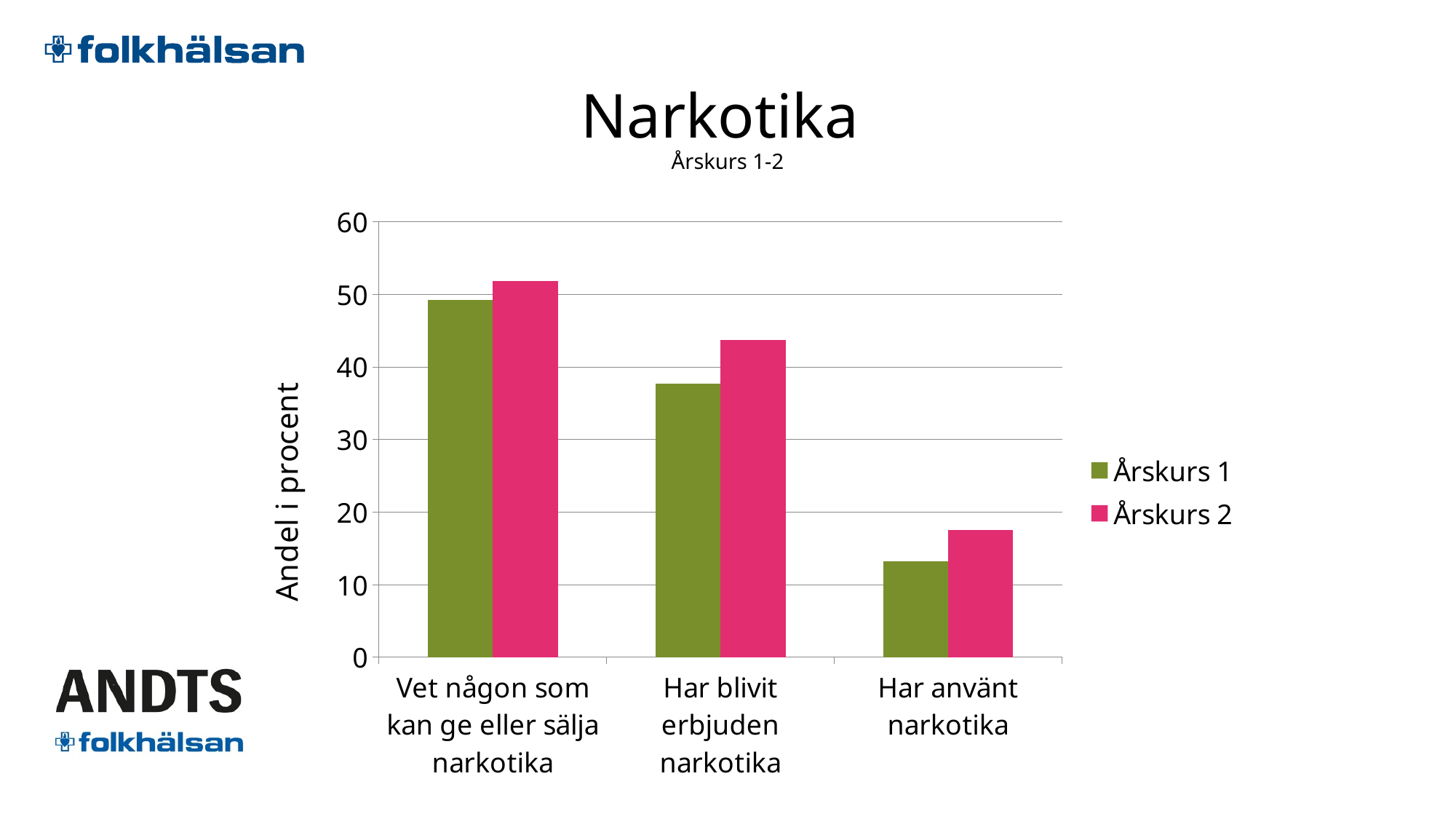
For 'Har blivit erbjuden narkotika', which series has the larger value, Årskurs 1 or Årskurs 2? Årskurs 2 How many series does the legend list? 2 Which category has the highest value for Årskurs 2? Vet någon som kan ge eller sälja narkotika Is the value for Årskurs 1 in 'Har använt narkotika' greater or less than 20? less How many categories are shown on the x axis? 3 What is the title of the chart? Narkotika Is the value for Årskurs 2 in 'Vet någon som kan ge eller sälja narkotika' greater or less than 50? greater Is the value for Årskurs 1 in 'Har blivit erbjuden narkotika' greater or less than 40? less Which category has the lowest value for Årskurs 1? Har använt narkotika What is the label on the vertical axis? Andel i procent What kind of chart is shown on the slide? bar chart Do the values for Årskurs 1 rise or fall from left to right across the categories? fall